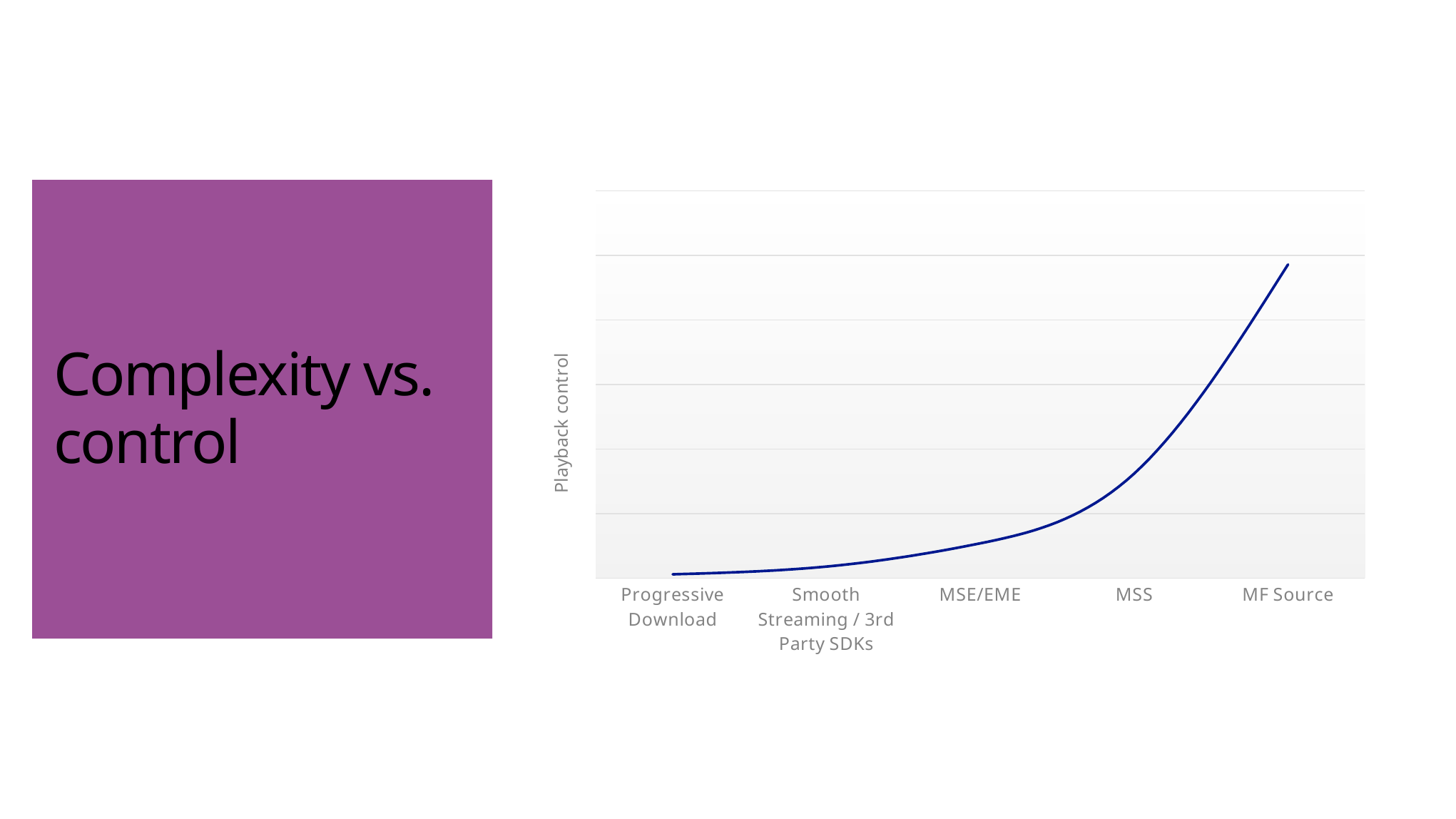
Which has the larger playback control value, Smooth Streaming / 3rd Party SDKs or MF Source? MF Source Which has the larger playback control value, MSS or MSE/EME? MSS Which category is plotted immediately after MSE/EME on the x axis? MSS How many categories are shown along the x axis of the chart? 5 Which category has the lowest playback control value on the chart? Progressive Download Does the line rise or fall as it moves from Progressive Download to MF Source? rises Which category has the highest playback control value on the chart? MF Source What is the label of the vertical axis of the chart? Playback control What kind of chart is shown on the slide? line chart